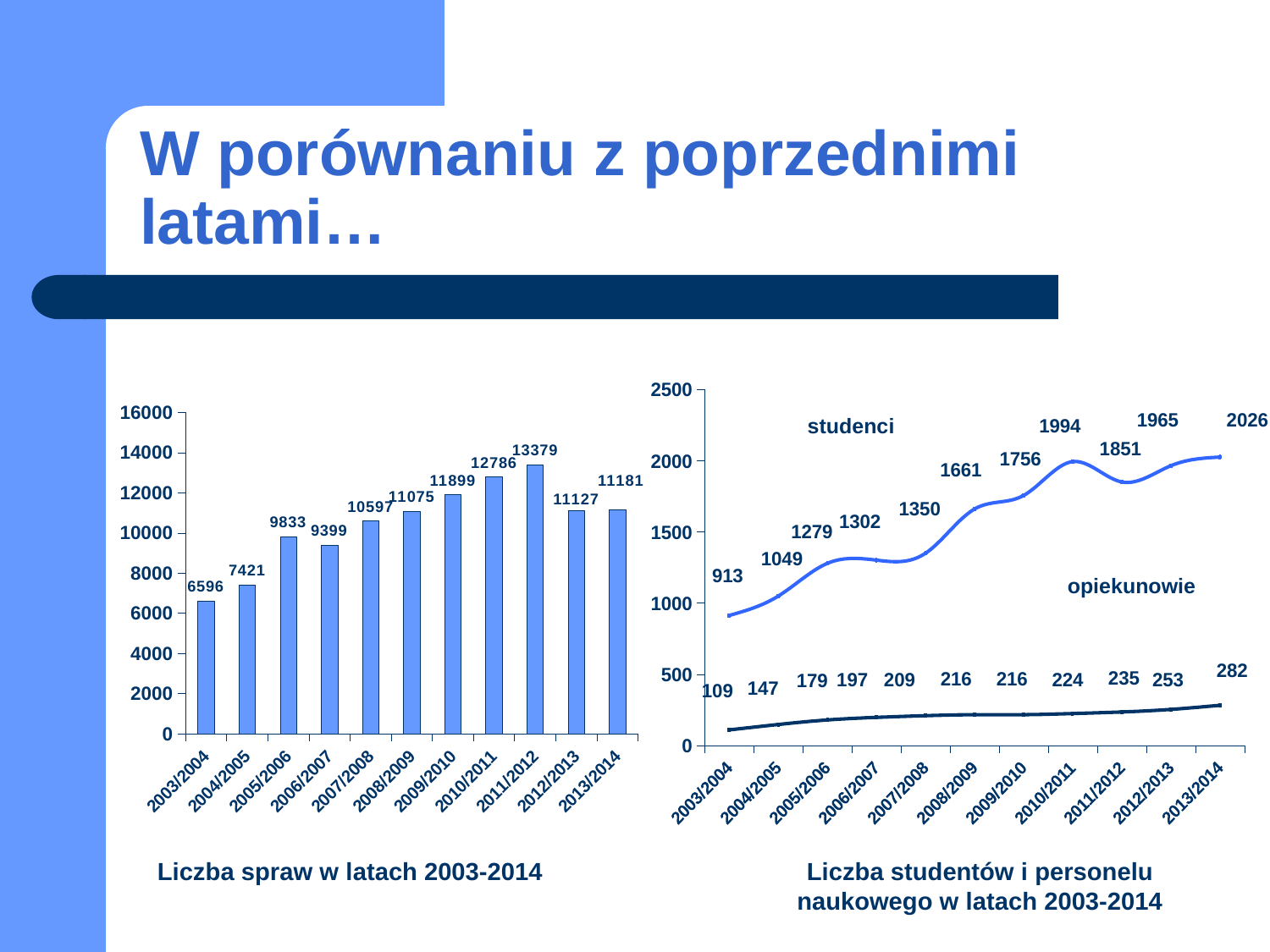
In the left chart (Liczba spraw w latach 2003-2014), which year has the highest value? 2011/2012 What kind of chart is the right chart (Liczba studentów i personelu naukowego w latach 2003-2014)? line chart In the left chart (Liczba spraw w latach 2003-2014), what is the value for 2007/2008? 10597 In the right chart (Liczba studentów i personelu naukowego w latach 2003-2014), what is the value for studenci in 2008/2009? 1661 What kind of chart is the left chart (Liczba spraw w latach 2003-2014)? bar chart In the left chart (Liczba spraw w latach 2003-2014), which year has the lowest value? 2003/2004 In the left chart (Liczba spraw w latach 2003-2014), how many years are shown on the x axis? 11 In the right chart (Liczba studentów i personelu naukowego w latach 2003-2014), what is the value for opiekunowie in 2013/2014? 282 In the right chart (Liczba studentów i personelu naukowego w latach 2003-2014), what is the difference between studenci and opiekunowie in 2003/2004? 804 In the right chart (Liczba studentów i personelu naukowego w latach 2003-2014), do the opiekunowie values generally rise or fall from 2003/2004 to 2013/2014? rise In the left chart (Liczba spraw w latach 2003-2014), what is the difference between the values for 2011/2012 and 2012/2013? 2252 In the left chart (Liczba spraw w latach 2003-2014), which is larger, the value for 2005/2006 or 2006/2007? 2005/2006